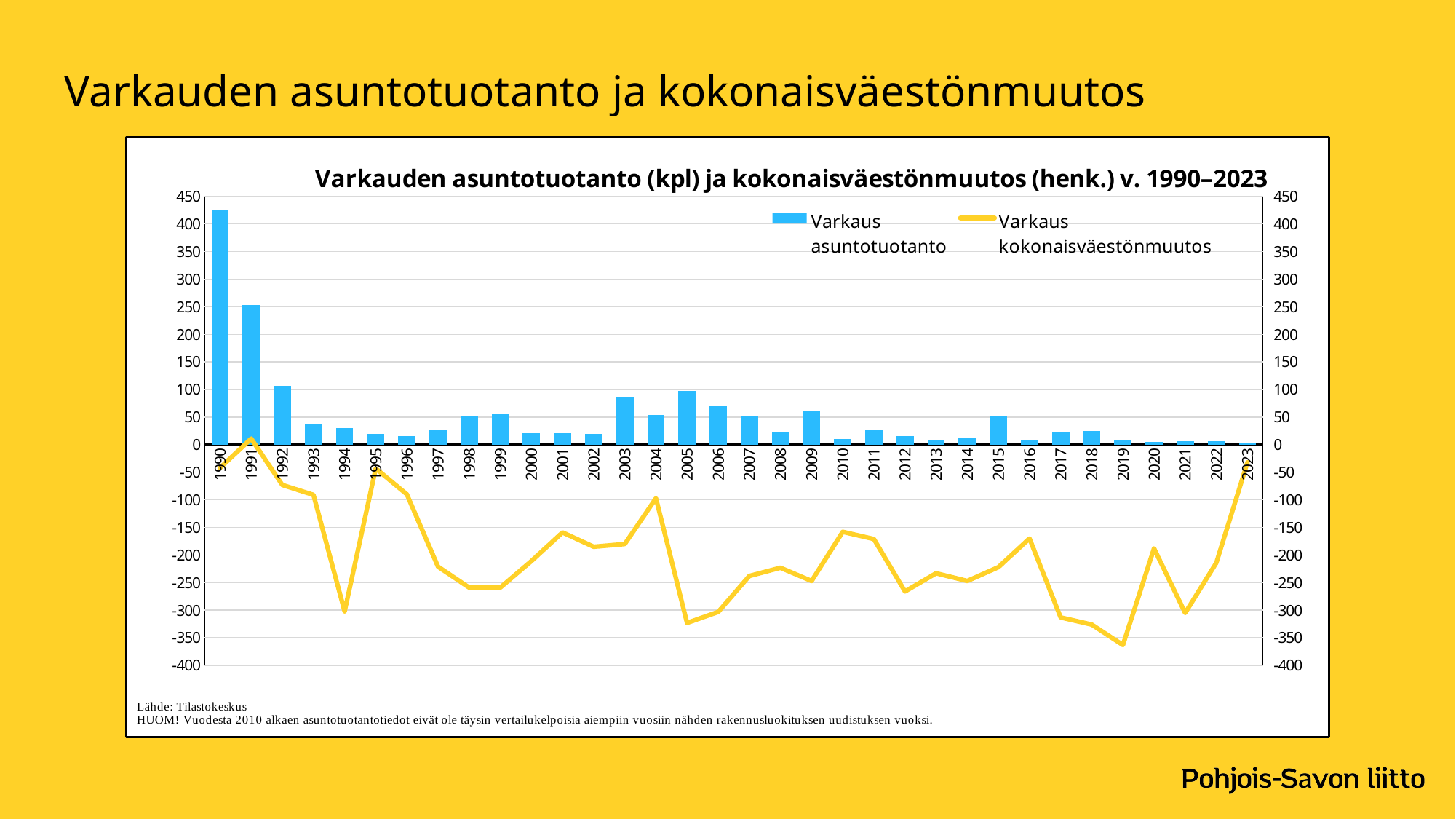
What colour is the Varkaus kokonaisväestönmuutos line? Yellow Which year has the highest value for Varkaus kokonaisväestönmuutos? 1991 Is the value for Varkaus kokonaisväestönmuutos in 2016 greater or less than -200? greater Is the value for Varkaus asuntotuotanto in 1990 greater or less than 400? greater Which year has the lowest value for Varkaus kokonaisväestönmuutos? 2019 Is the value for Varkaus kokonaisväestönmuutos in 2019 greater or less than -350? less How many series does the legend list? 2 Which year has the highest value for Varkaus asuntotuotanto? 1990 What kind of chart is shown on the slide? A combined bar and line chart Which is larger, the Varkaus asuntotuotanto value for 2003 or for 2004? 2003 How many years are shown on the x axis? 34